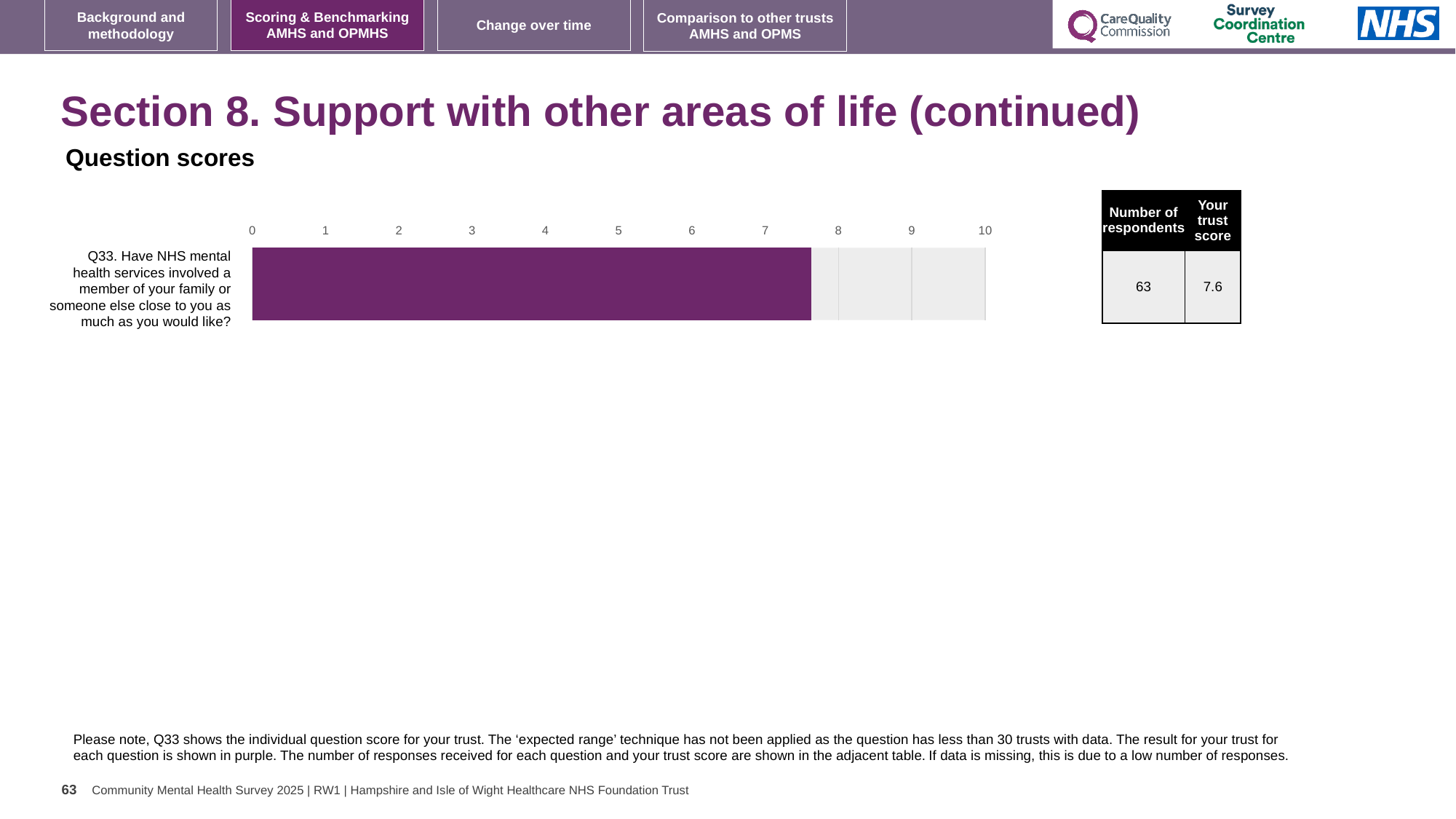
What is the maximum value shown on the chart's axis? 10 Is the value of the bar for Q33 greater or less than 8? less What colour is the bar showing the trust's result for Q33? Purple What is the trust score for Q33 shown in the table next to the chart? 7.6 How many questions (bars) are plotted on the chart? 1 Is the value of the bar for Q33 greater or less than 5? greater How many respondents answered Q33 according to the table? 63 Is the value of the bar for Q33 greater or less than 7? greater What kind of chart is shown on the slide? Bar chart